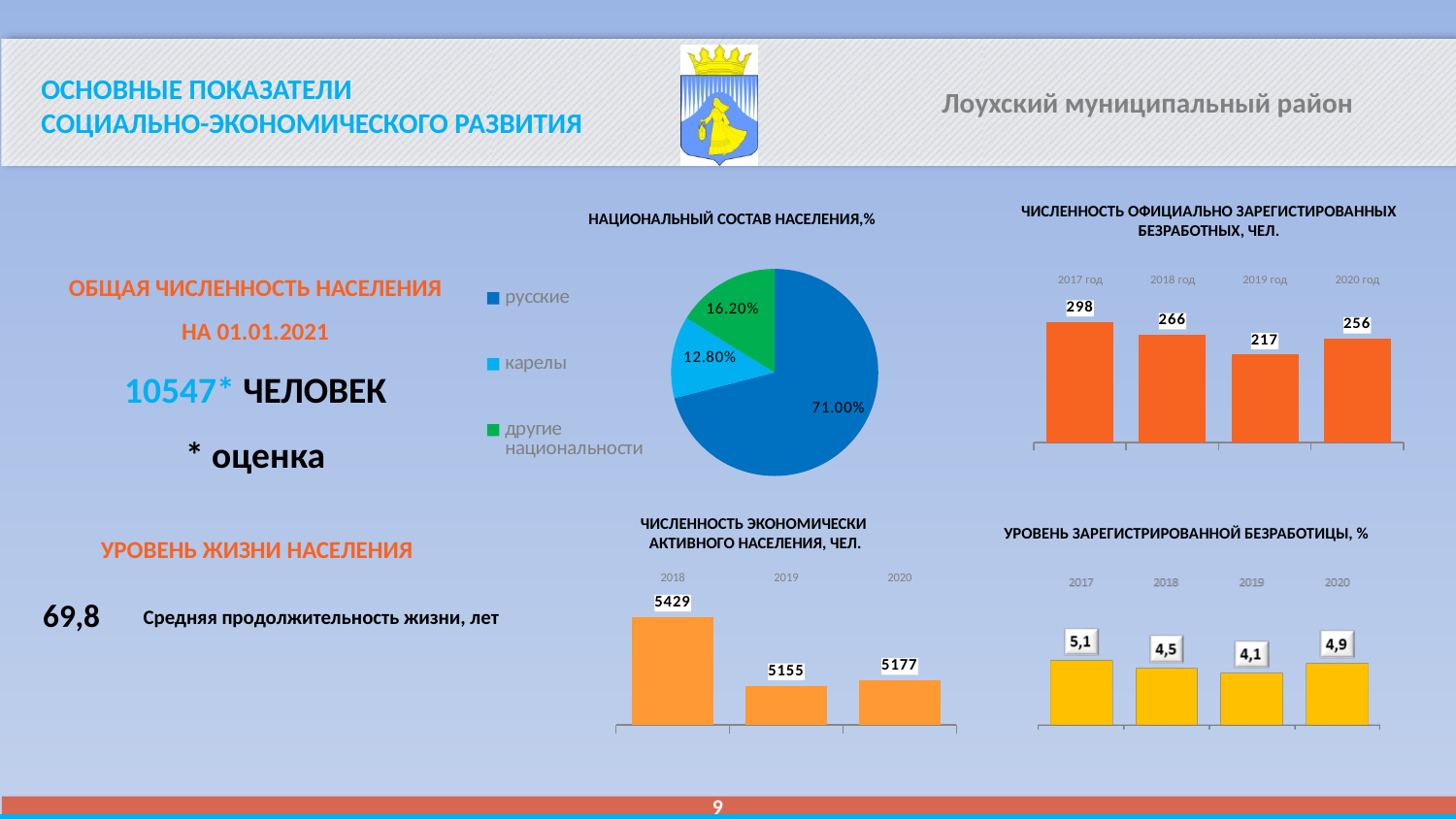
In the chart 'ЧИСЛЕННОСТЬ ЭКОНОМИЧЕСКИ АКТИВНОГО НАСЕЛЕНИЯ, ЧЕЛ.', what kind of chart is it? bar chart In the pie chart 'НАЦИОНАЛЬНЫЙ СОСТАВ НАСЕЛЕНИЯ,%', what share is shown for карелы? 12.80% In the pie chart 'НАЦИОНАЛЬНЫЙ СОСТАВ НАСЕЛЕНИЯ,%', what share is shown for русские? 71.00% In the pie chart 'НАЦИОНАЛЬНЫЙ СОСТАВ НАСЕЛЕНИЯ,%', how many entries does the legend list? 3 In the chart 'ЧИСЛЕННОСТЬ ОФИЦИАЛЬНО ЗАРЕГИСТРИРОВАННЫХ БЕЗРАБОТНЫХ, ЧЕЛ.', how many years are shown? 4 In the chart 'ЧИСЛЕННОСТЬ ЭКОНОМИЧЕСКИ АКТИВНОГО НАСЕЛЕНИЯ, ЧЕЛ.', what is the value for 2018? 5429 In the chart 'УРОВЕНЬ ЗАРЕГИСТРИРОВАННОЙ БЕЗРАБОТИЦЫ, %', which is larger, the value for 2017 or the value for 2019? 2017 In the chart 'ЧИСЛЕННОСТЬ ОФИЦИАЛЬНО ЗАРЕГИСТРИРОВАННЫХ БЕЗРАБОТНЫХ, ЧЕЛ.', which year has the highest value? 2017 год In the chart 'ЧИСЛЕННОСТЬ ЭКОНОМИЧЕСКИ АКТИВНОГО НАСЕЛЕНИЯ, ЧЕЛ.', which year has the lowest value? 2019 In the chart 'ЧИСЛЕННОСТЬ ОФИЦИАЛЬНО ЗАРЕГИСТРИРОВАННЫХ БЕЗРАБОТНЫХ, ЧЕЛ.', what is the difference between the values for 2017 год and 2018 год? 32 In the chart 'ЧИСЛЕННОСТЬ ОФИЦИАЛЬНО ЗАРЕГИСТРИРОВАННЫХ БЕЗРАБОТНЫХ, ЧЕЛ.', what is the value for 2019 год? 217 In the chart 'УРОВЕНЬ ЗАРЕГИСТРИРОВАННОЙ БЕЗРАБОТИЦЫ, %', what is the value for 2020? 4,9